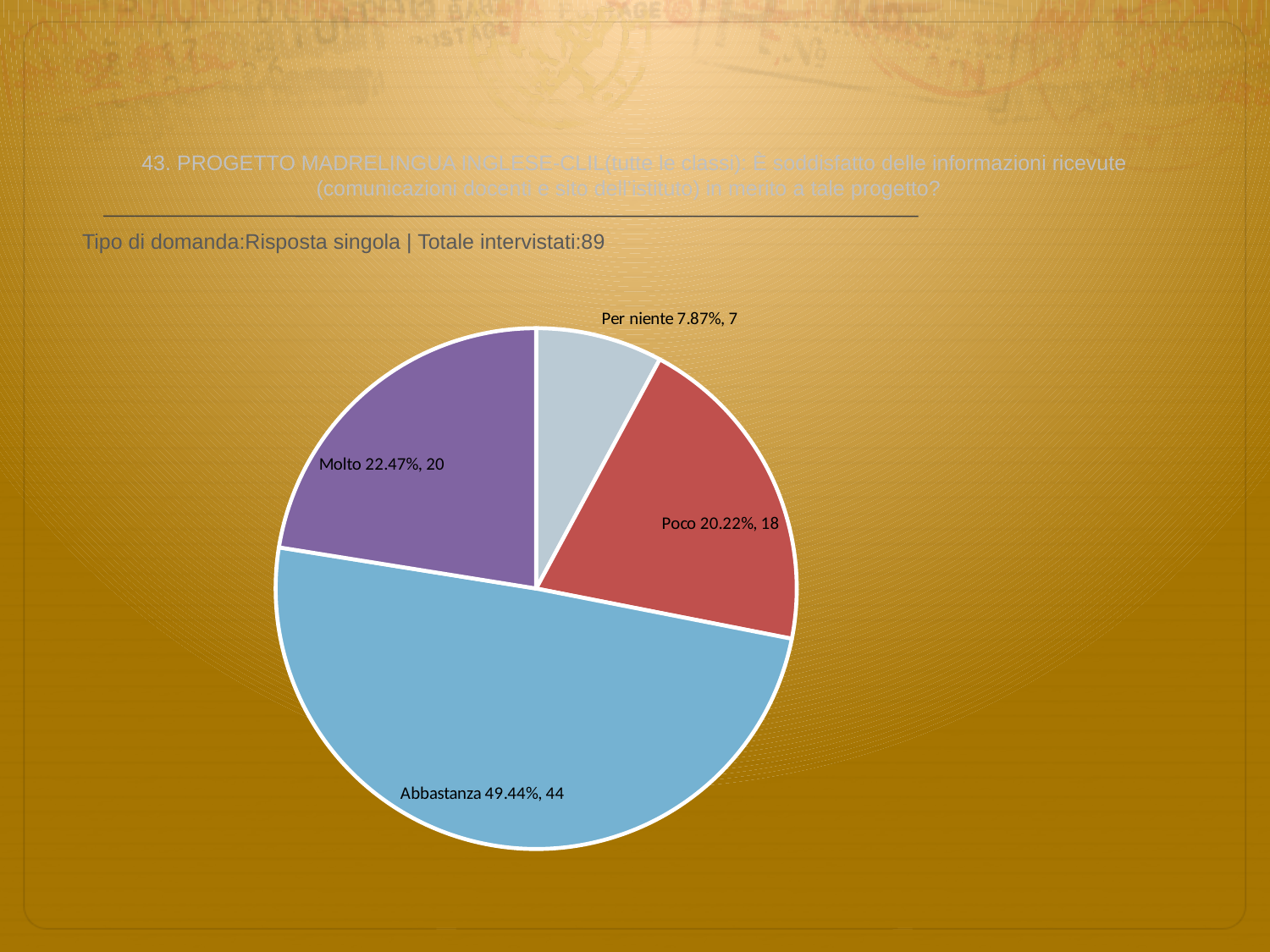
What kind of chart is shown on the slide? pie chart How many slices does the pie chart have? 4 Which slice is larger, Molto or Poco? Molto Which category has the smallest slice of the pie? Per niente What is the share of the pie for the Molto slice? 22.47% What colour is the Abbastanza slice? blue Which category has the largest slice of the pie? Abbastanza How many respondents answered Per niente? 7 How many respondents answered Molto? 20 What is the difference in respondent count between Abbastanza and Molto? 24 What percentage is shown for the Abbastanza slice? 49.44% What percentage is shown for the Poco slice? 20.22%